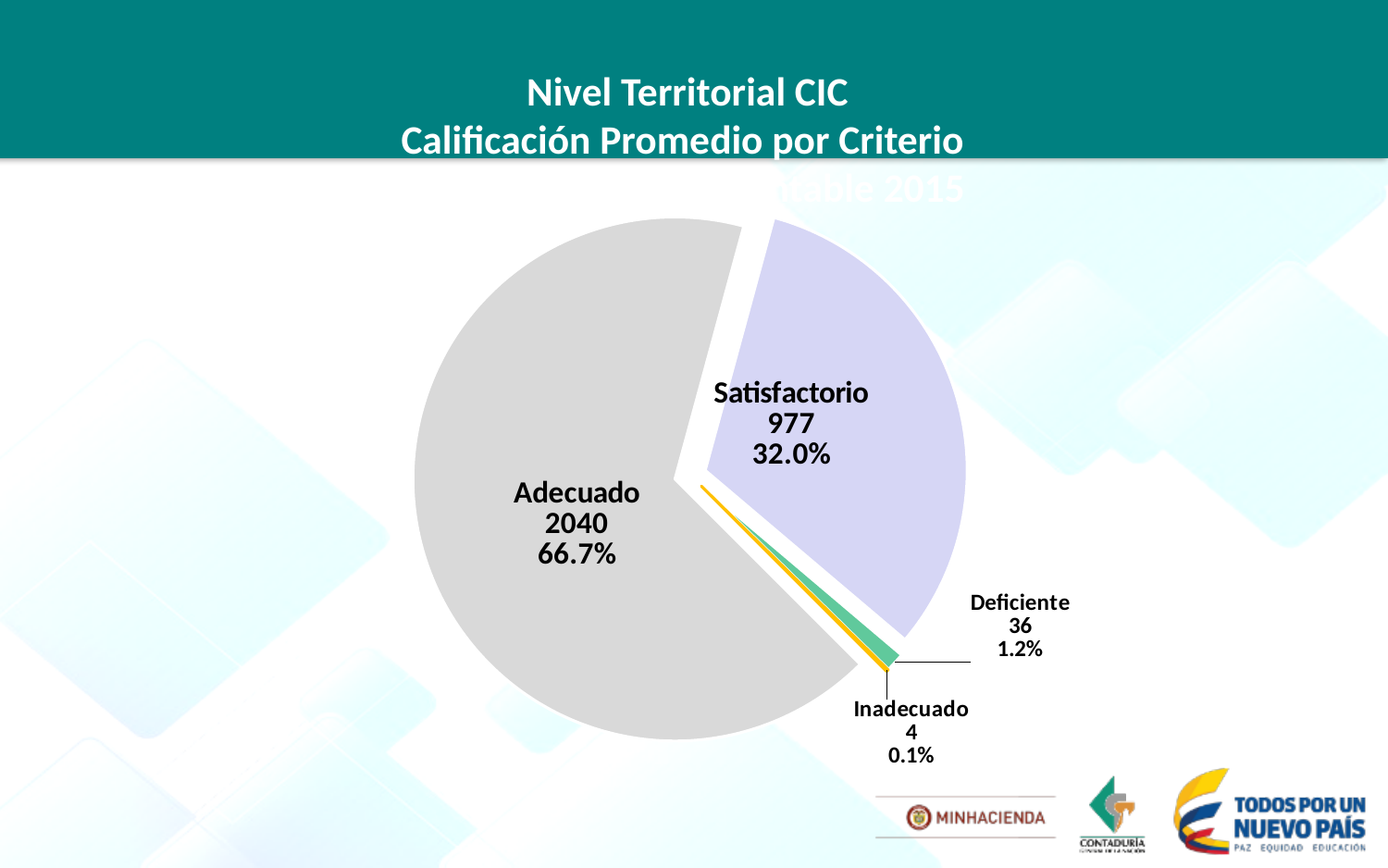
How many slices does the pie chart have? 4 Which category has the smallest slice of the pie? Inadecuado What is the value shown for Adecuado? 2040 What is the total of the four values shown on the pie chart? 3057 What percentage share does Satisfactorio have? 32.0% What is the difference between the values for Adecuado and Satisfactorio? 1063 What kind of chart is shown on the slide? pie chart Which is larger, the value for Deficiente or the value for Inadecuado? Deficiente Which category has the largest slice of the pie? Adecuado What percentage share does Inadecuado have? 0.1% What is the title of the chart on the slide? Nivel Territorial CIC Calificación Promedio por Criterio What is the value shown for Deficiente? 36